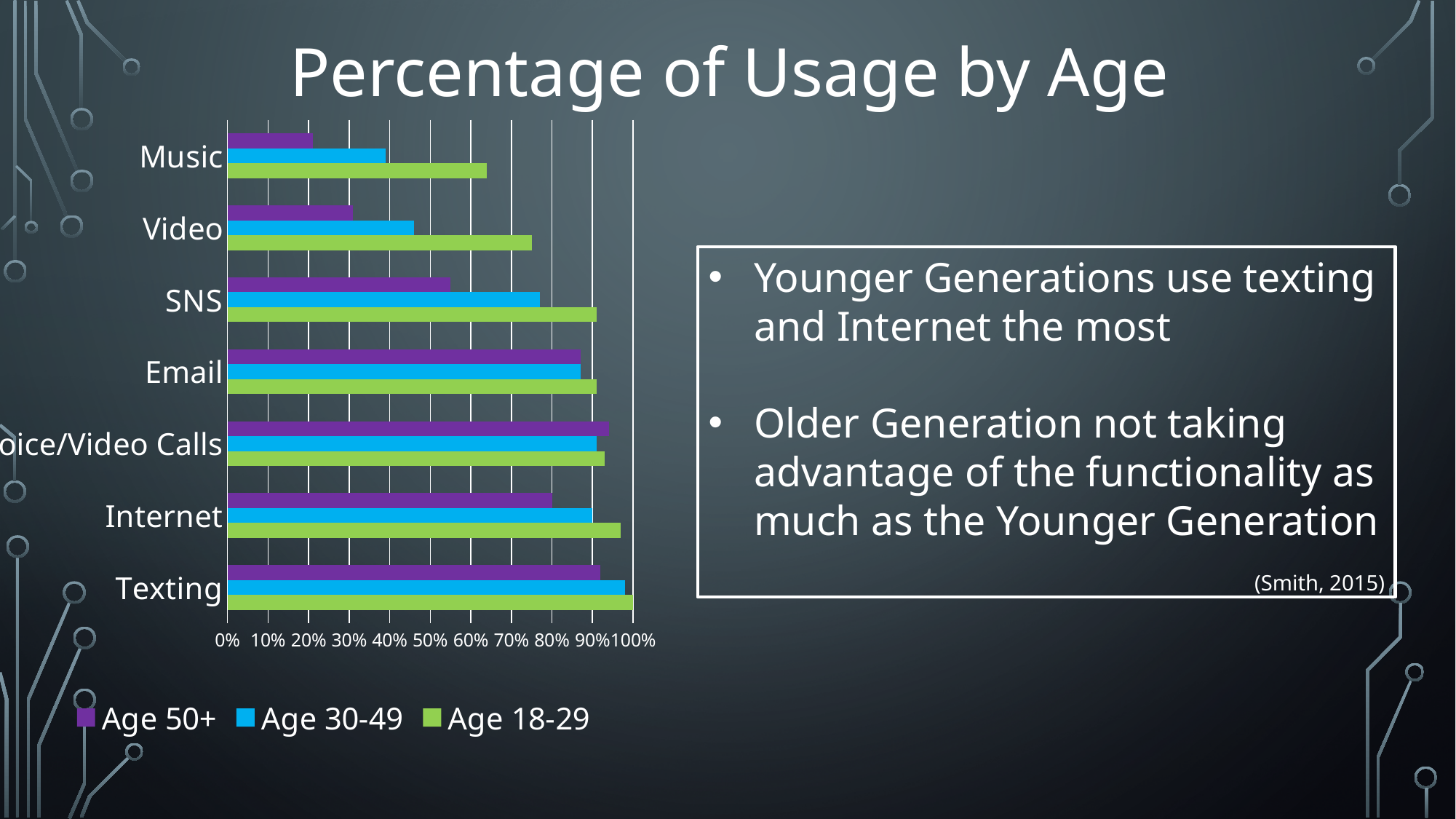
Is the value for Music in the Age 50+ series greater or less than 30%? less Which category has the lowest value for the Age 18-29 series? Music Is the value for SNS in the Age 50+ series greater or less than 50%? greater What kind of chart is shown on the slide? Bar chart For Video, which is larger: the Age 30-49 value or the Age 50+ value? Age 30-49 Is the value for Music in the Age 18-29 series greater or less than 60%? greater Which age group is shown in green in the legend? Age 18-29 How many series does the legend list? 3 Which category has the lowest value for the Age 50+ series? Music How many categories are plotted on the chart? 7 What is the title of the chart? Percentage of Usage by Age